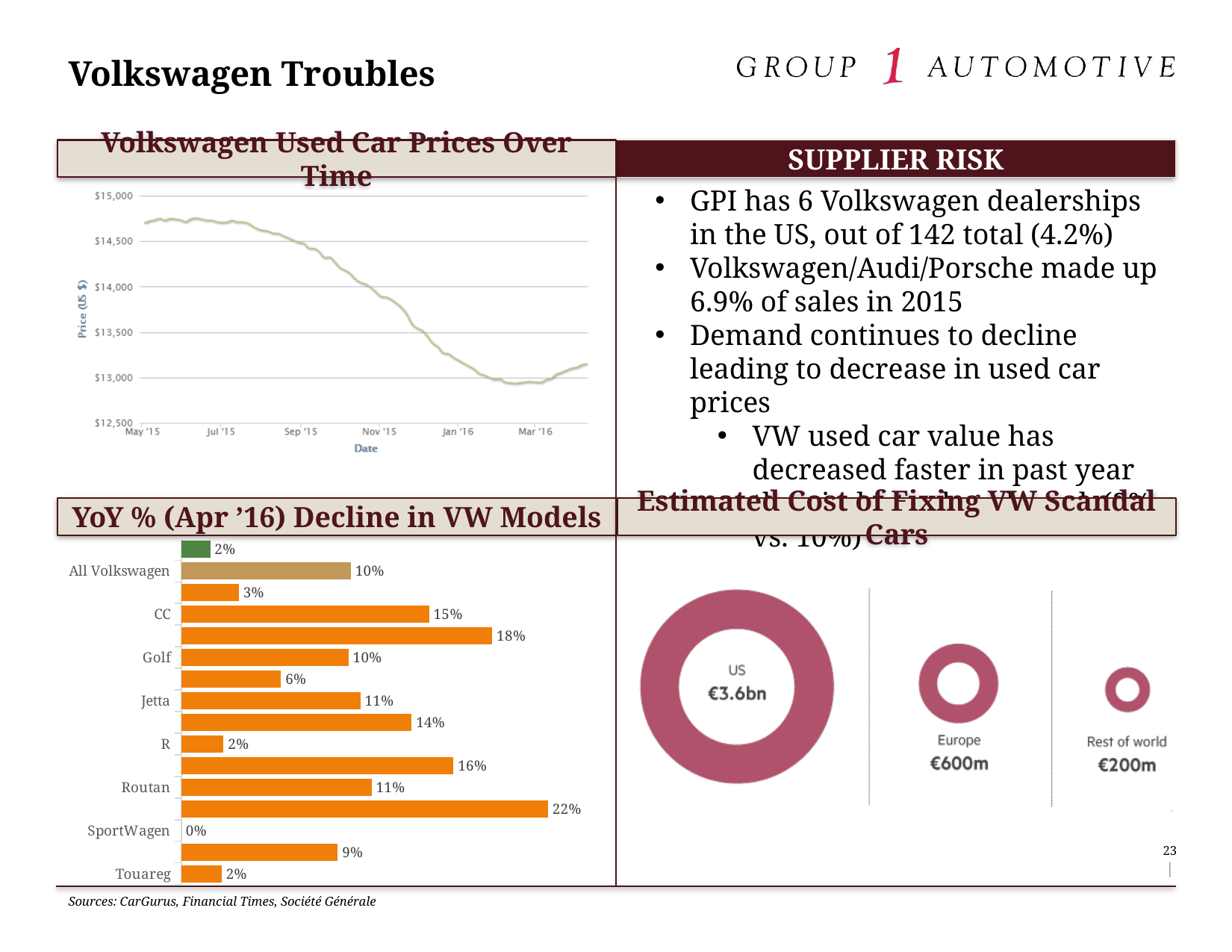
How many regions are shown in the 'Estimated Cost of Fixing VW Scandal Cars' chart? 3 In the 'YoY % (Apr '16) Decline in VW Models' chart, what is the highest value shown on any bar? 22% In the 'Estimated Cost of Fixing VW Scandal Cars' chart, which region has the highest estimated cost? US In the 'Volkswagen Used Car Prices Over Time' chart, is the price at Jan '16 greater or less than $13,500? less In the 'YoY % (Apr '16) Decline in VW Models' chart, which is larger, the value for Jetta or the value for R? Jetta In the 'YoY % (Apr '16) Decline in VW Models' chart, what is the difference between the values for CC and Golf? 5% In the 'YoY % (Apr '16) Decline in VW Models' chart, what is the value for All Volkswagen? 10% In the 'YoY % (Apr '16) Decline in VW Models' chart, what is the value for SportWagen? 0% In the 'Volkswagen Used Car Prices Over Time' chart, do prices rise or fall between May '15 and Jan '16? Fall In the 'YoY % (Apr '16) Decline in VW Models' chart, what is the value for CC? 15% What kind of chart is 'YoY % (Apr '16) Decline in VW Models'? Bar chart In the 'Estimated Cost of Fixing VW Scandal Cars' chart, what is the estimated cost for Europe? €600m